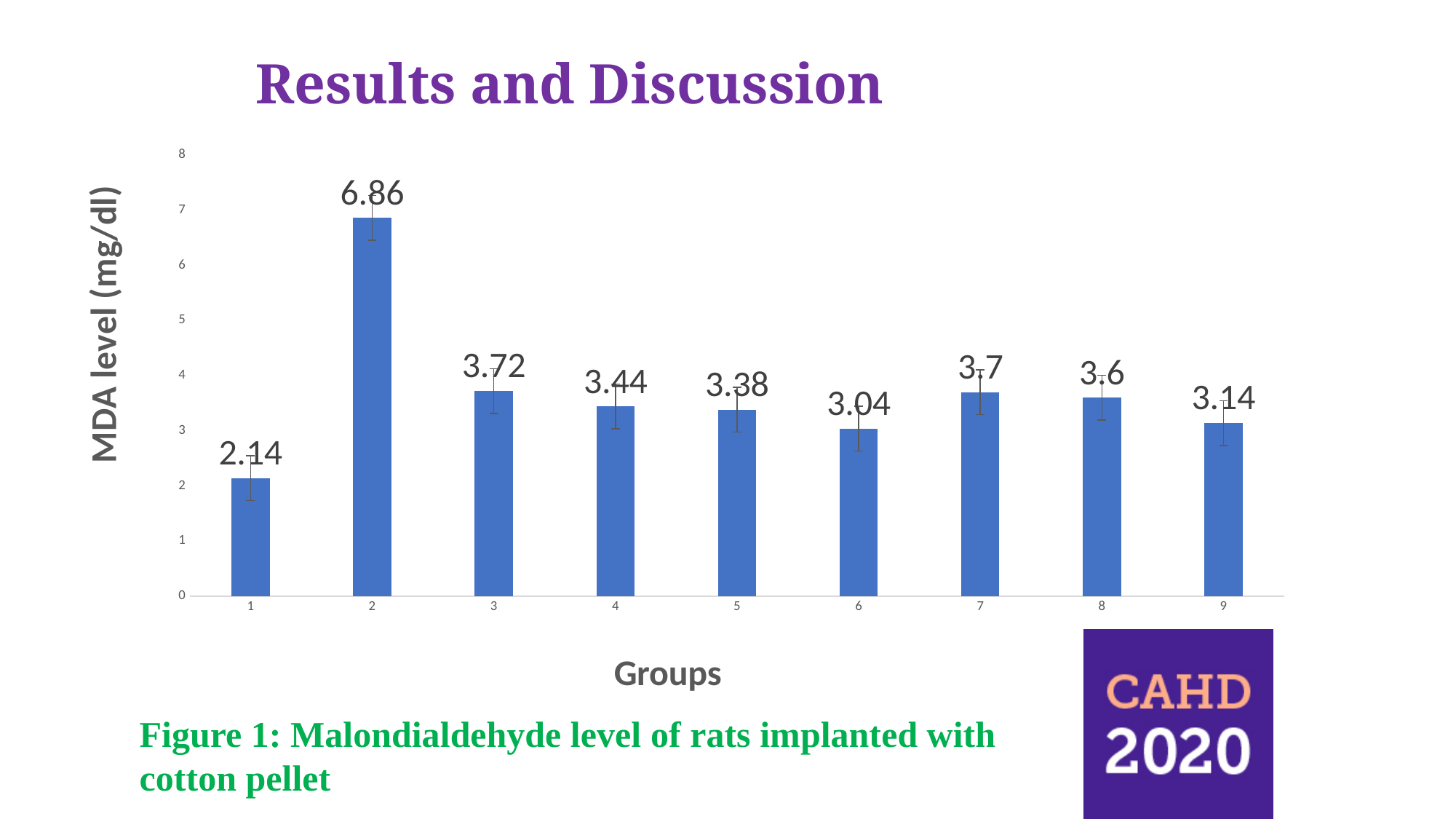
What is the MDA level for group 9? 3.14 What is the MDA level for group 2? 6.86 What kind of chart is shown on the slide? bar chart What is the MDA level for group 6? 3.04 Is the MDA level for group 2 greater or less than 6? greater What is the label of the y axis? MDA level (mg/dl) Which group has the highest MDA level? 2 Which has a higher MDA level, group 4 or group 8? group 8 What is the difference in MDA level between group 2 and group 1? 4.72 What is the difference in MDA level between group 3 and group 6? 0.68 Which group has the lowest MDA level? 1 How many groups are shown on the x axis? 9